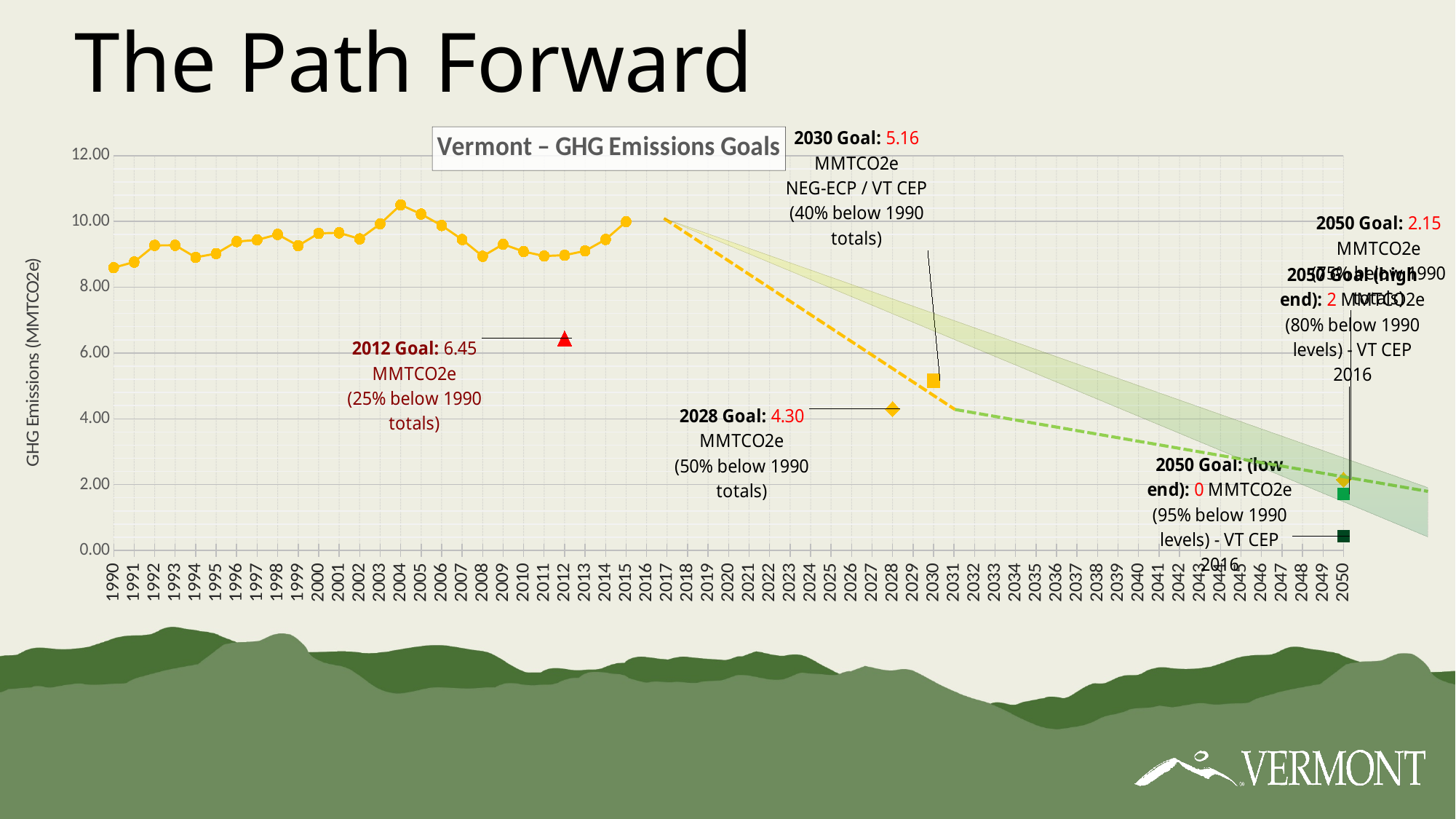
Which is larger, the 2028 Goal or the 2030 Goal? 2030 Goal What is the 2012 Goal value shown on the chart? 6.45 MMTCO2e What is the 2030 Goal value shown on the chart? 5.16 MMTCO2e What is the label on the y-axis of the chart? GHG Emissions (MMTCO2e) What is the difference between the 2012 Goal (6.45) and the 2028 Goal (4.30)? 2.15 What is the 2028 Goal value shown on the chart? 4.30 MMTCO2e What is the 2050 Goal (low end) value shown on the chart? 0 MMTCO2e What kind of chart is shown on the slide? line chart What is the title of the chart? Vermont – GHG Emissions Goals Is the historical GHG emissions value for 1990 greater or less than 10.00? less Is the historical GHG emissions value for 2004 greater or less than 10.00? greater What percentage below 1990 totals does the 2030 Goal represent? 40%